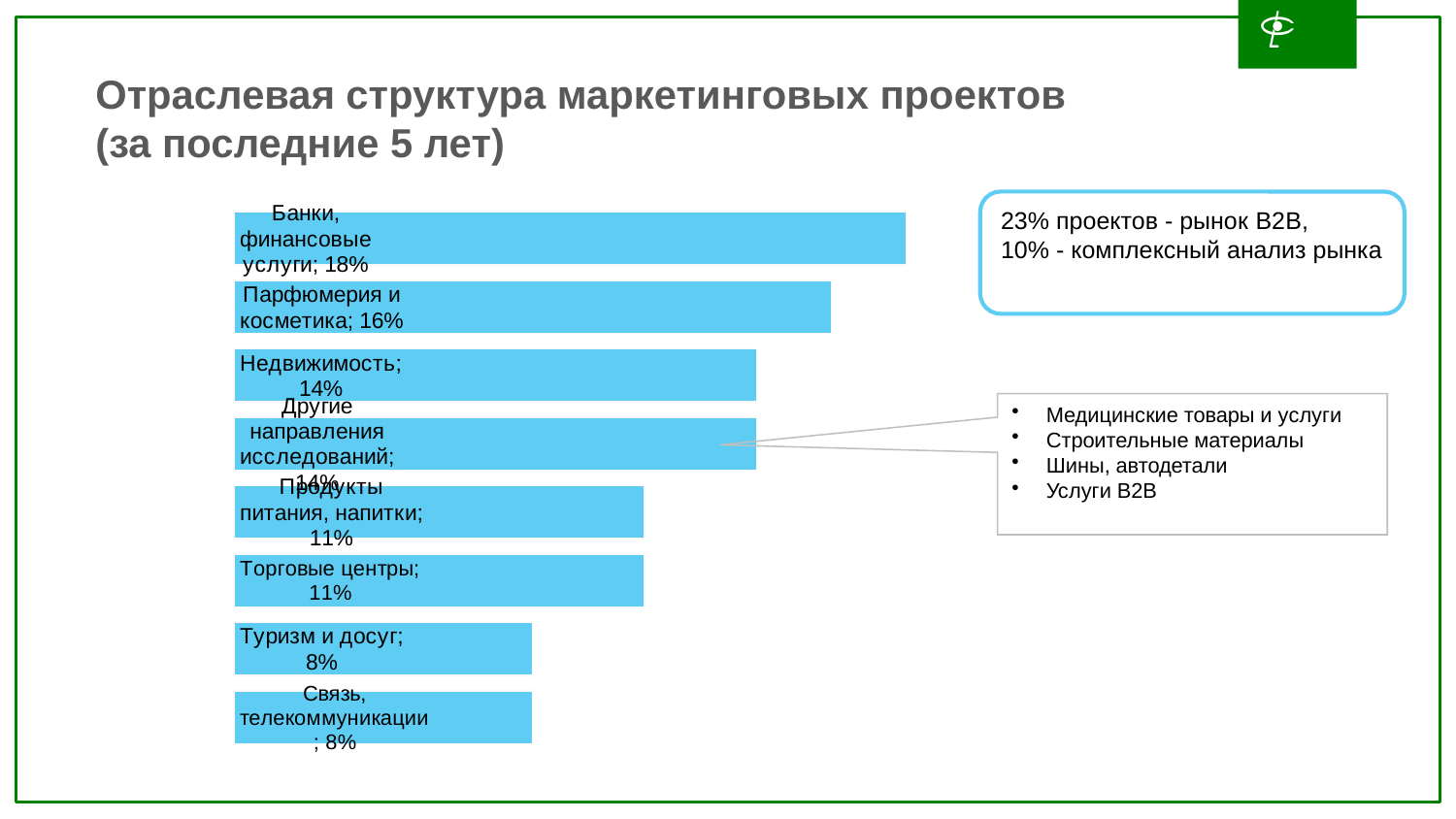
What is the value for Банки, финансовые услуги? 18% What is the title of the slide containing the chart? Отраслевая структура маркетинговых проектов (за последние 5 лет) What is the difference between the values for Банки, финансовые услуги and Связь, телекоммуникации? 10% What is the value for Туризм и досуг? 8% Which category has the highest value? Банки, финансовые услуги What is the value for Парфюмерия и косметика? 16% What is the value for Торговые центры? 11% What is the value for Недвижимость? 14% What kind of chart is shown on the slide? bar chart Which is larger, the value for Недвижимость or the value for Туризм и досуг? Недвижимость How many categories are shown in the chart? 8 What is the difference between the values for Парфюмерия и косметика and Продукты питания, напитки? 5%